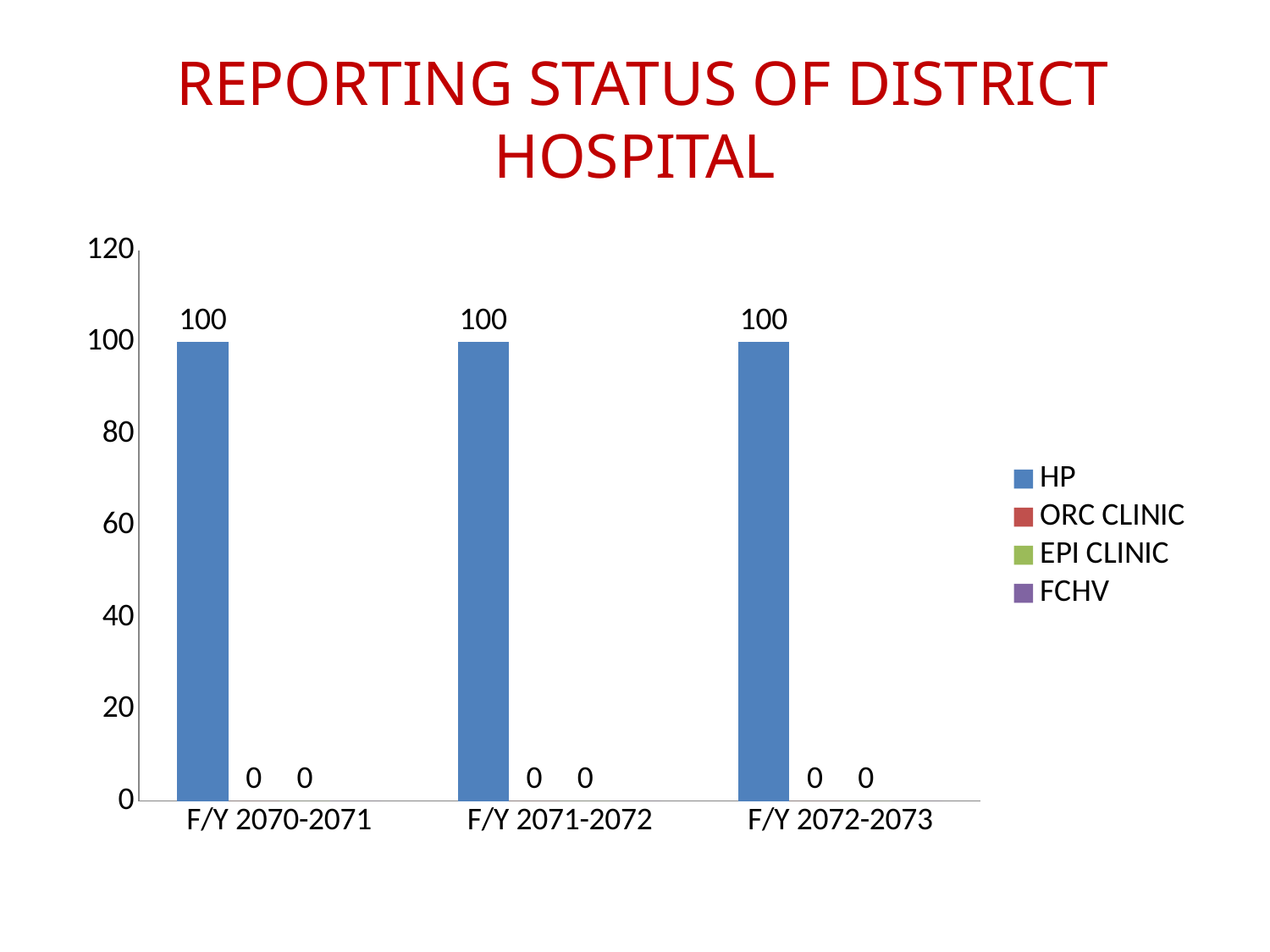
What kind of chart is shown on the slide? bar chart What is the value for HP in F/Y 2072-2073? 100 What is the value for HP in F/Y 2071-2072? 100 How many series does the legend list? 4 What is the title of the chart? REPORTING STATUS OF DISTRICT HOSPITAL What is the difference between the HP value in F/Y 2070-2071 and the HP value in F/Y 2072-2073? 0 Which series has the highest value in F/Y 2072-2073? HP What is the value for HP in F/Y 2070-2071? 100 Does the HP value rise, fall, or stay the same across the fiscal years? stays the same Is the HP value for F/Y 2071-2072 greater or less than 80? greater Which series is shown in blue in the legend? HP How many fiscal year categories are shown on the x axis? 3